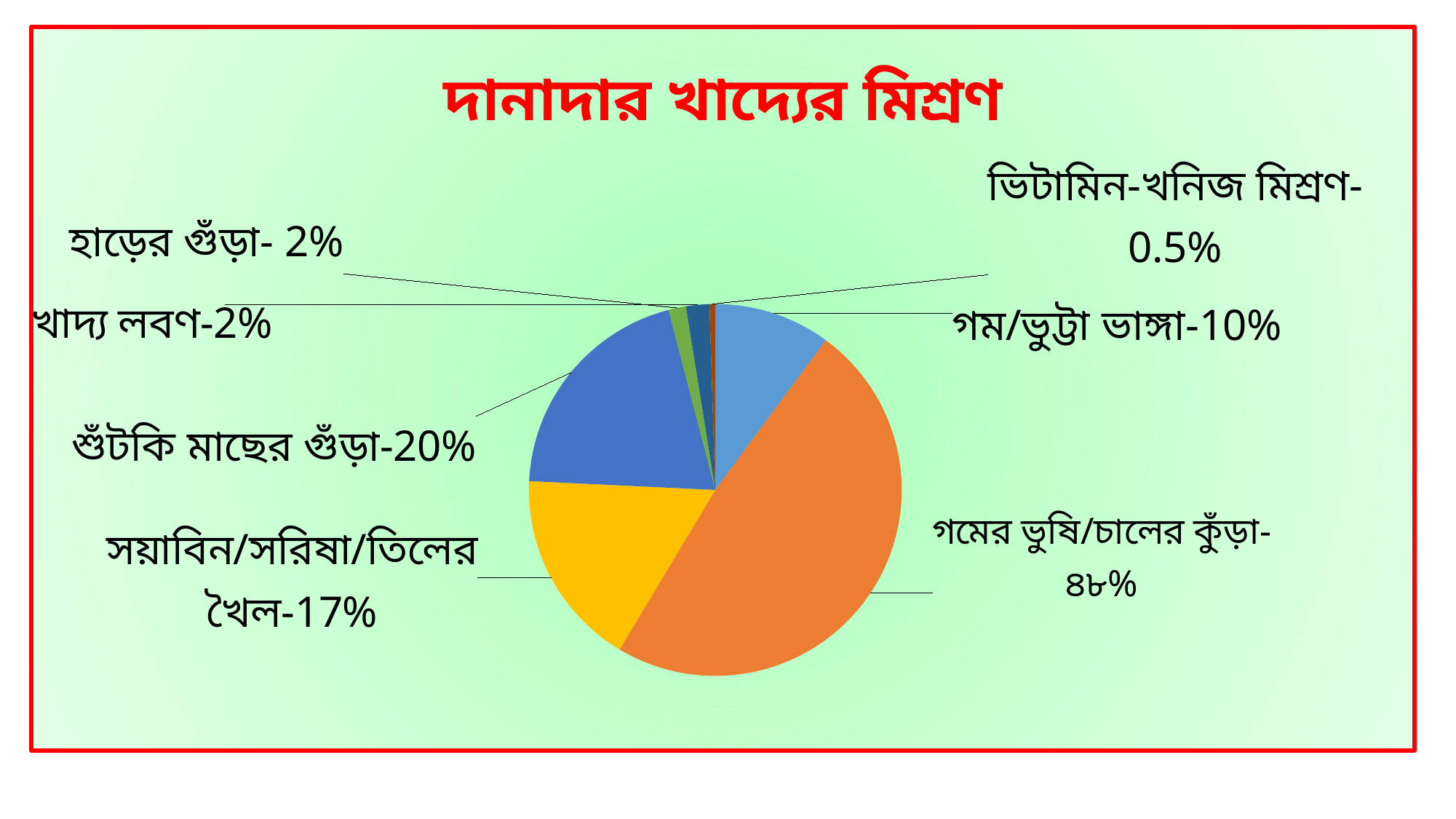
Which has a larger share, গম/ভুট্টা ভাঙ্গা or হাড়ের গুঁড়া? গম/ভুট্টা ভাঙ্গা What share of the mixture is শুঁটকি মাছের গুঁড়া? 20% What is the title of the chart? দানাদার খাদ্যের মিশ্রণ What share of the mixture is গম/ভুট্টা ভাঙ্গা? 10% How many slices does the pie chart have? 7 What share of the mixture is ভিটামিন-খনিজ মিশ্রণ? 0.5% What share of the mixture is গমের ভুষি/চালের কুঁড়া? ৪৮% What is the difference between the shares of শুঁটকি মাছের গুঁড়া and সয়াবিন/সরিষা/তিলের খৈল? 3% Which ingredient has the largest share of the mixture? গমের ভুষি/চালের কুঁড়া What share of the mixture is সয়াবিন/সরিষা/তিলের খৈল? 17% Which ingredient has the smallest share of the mixture? ভিটামিন-খনিজ মিশ্রণ What kind of chart is shown on the slide? pie chart